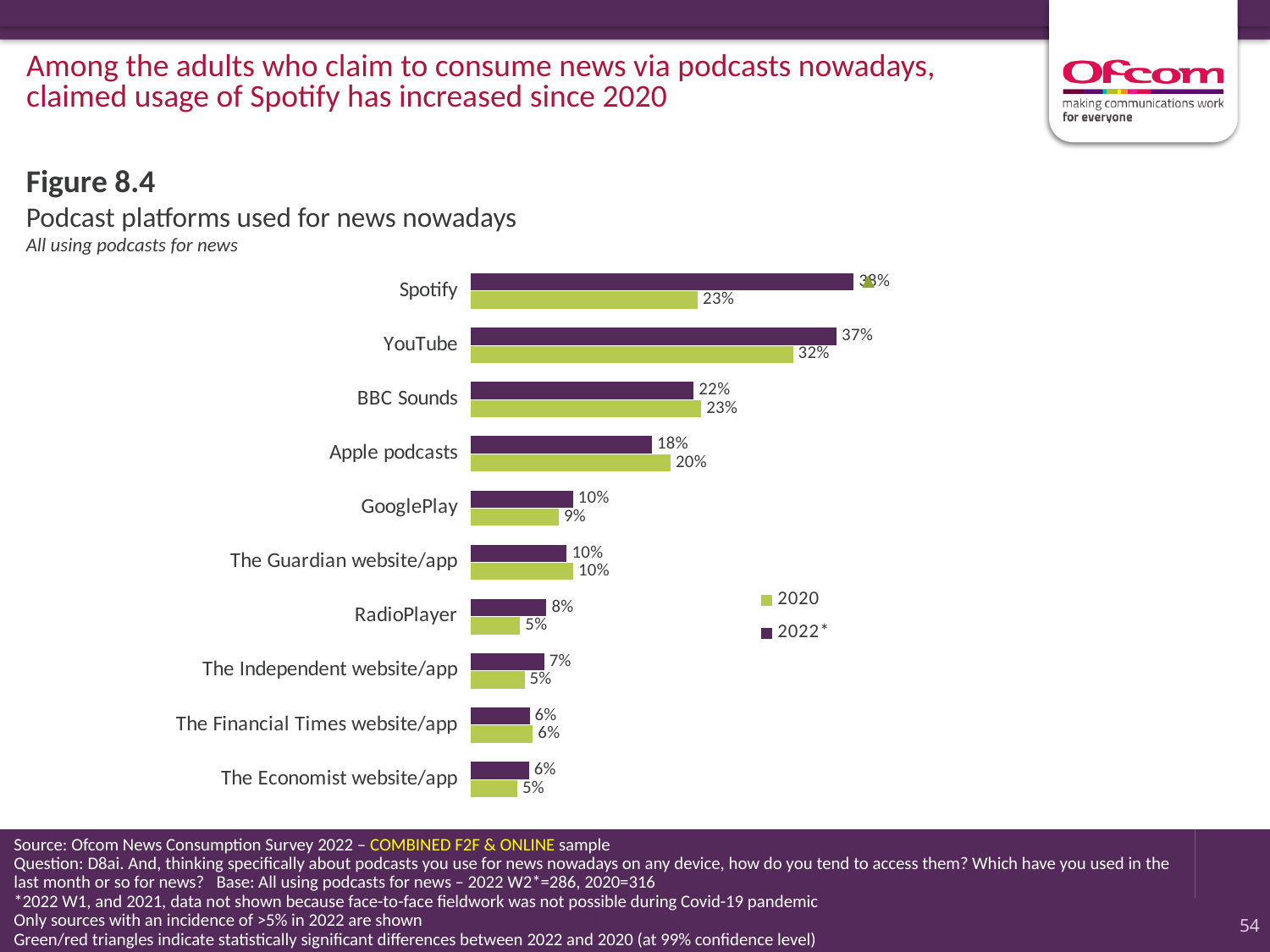
What is the 2022* value for BBC Sounds? 22% Which is larger for Apple podcasts, the 2020 value or the 2022* value? 2020 Which platform has the highest 2020 value? YouTube What is the title of the figure shown on the slide? Podcast platforms used for news nowadays What is the 2022* value for RadioPlayer? 8% What is the 2020 value for Apple podcasts? 20% What is the 2020 value for YouTube? 32% How many series does the legend list? 2 How many podcast platforms are listed on the chart? 10 What is the difference between the 2022* and 2020 values for YouTube? 5% What is the difference between the 2022* and 2020 values for The Independent website/app? 2% What type of chart is shown on the slide? bar chart